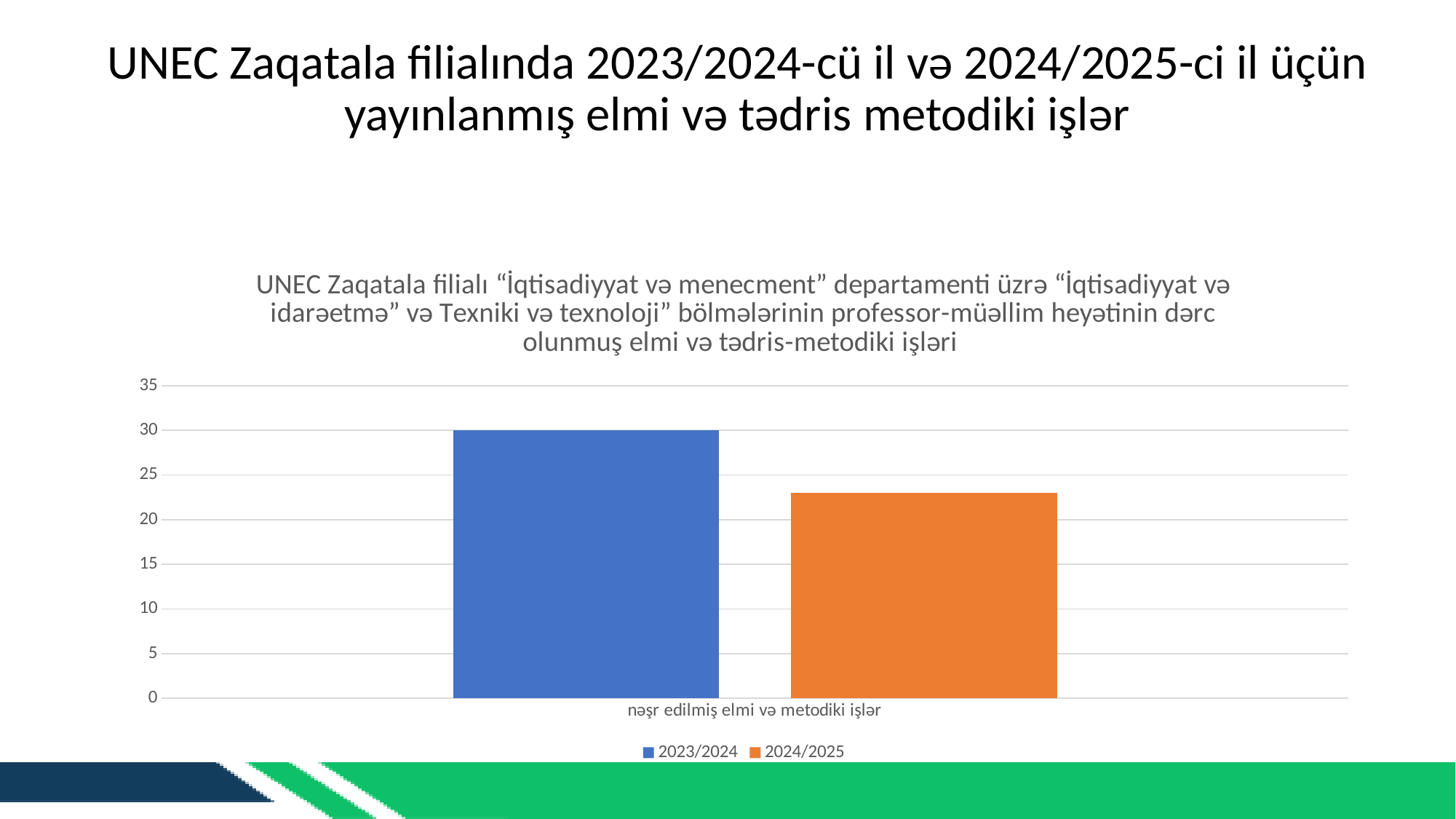
How many series does the legend list? 2 What is the category label shown on the x axis? nəşr edilmiş elmi və metodiki işlər What is the maximum value shown on the y axis? 35 How many categories are shown on the x axis? 1 Which series has the higher value, 2023/2024 or 2024/2025? 2023/2024 What colour is the bar for the 2024/2025 series? orange What kind of chart is shown on the slide? bar chart What is the value for the 2023/2024 series? 30 Is the value for the 2024/2025 series greater or less than 20? greater Is the value for the 2024/2025 series greater or less than 25? less Which series has the lowest bar? 2024/2025 Which series has the highest bar? 2023/2024